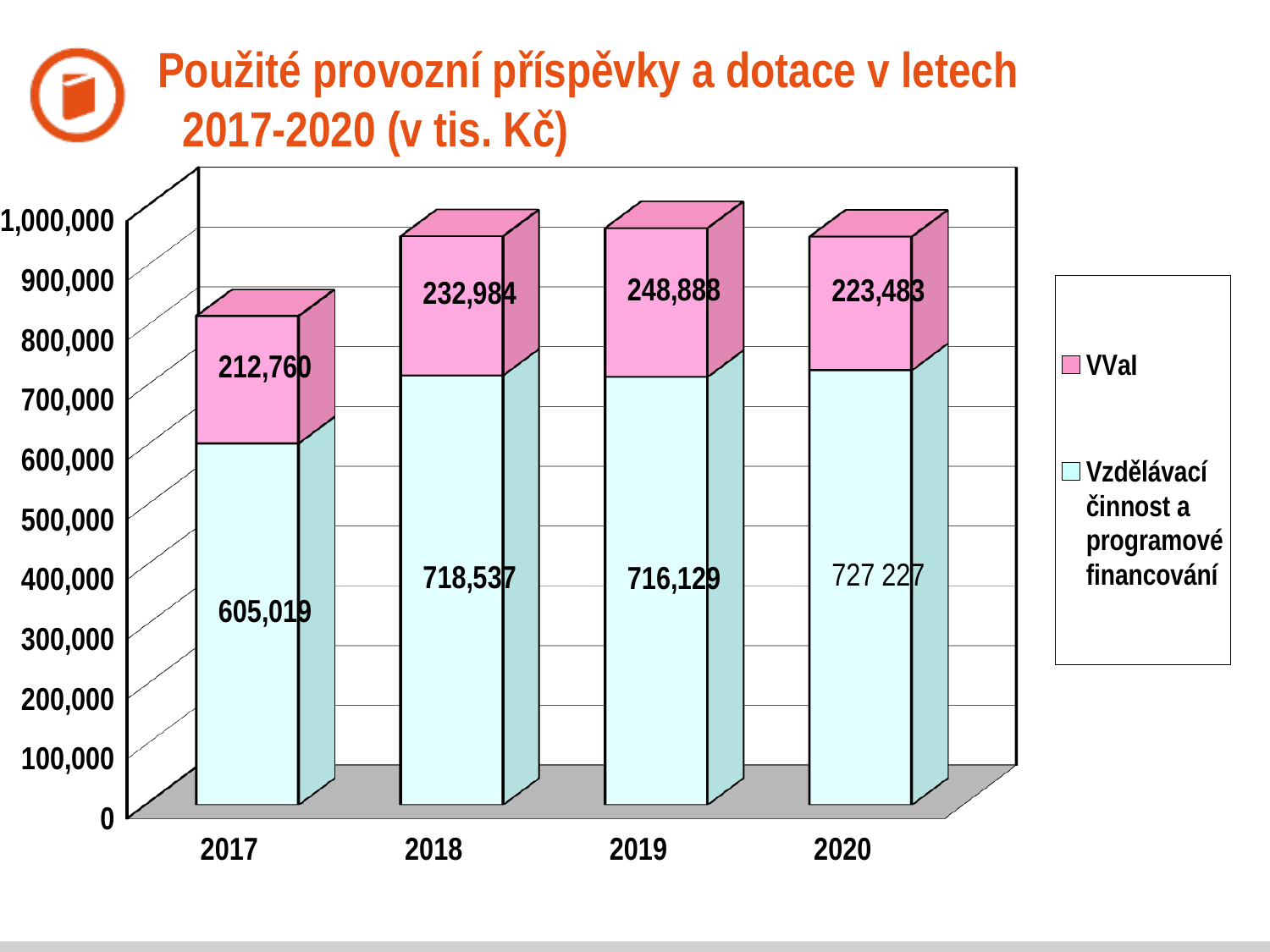
What kind of chart is shown on the slide? Stacked bar chart In which year is the Vzdělávací činnost a programové financování value lowest? 2017 What is the value for Vzdělávací činnost a programové financování in 2017? 605,019 In which year is the VVaI value highest? 2019 How many years are shown on the x axis? 4 What is the difference between the VVaI values for 2018 and 2017? 20,224 Which is larger, the VVaI value for 2020 or for 2018? 2018 What is the value for Vzdělávací činnost a programové financování in 2020? 727 227 What is the value for VVaI in 2019? 248,888 What is the total of the stacked bar for 2017? 817,779 How many series does the legend list? 2 What is the total of the stacked bar for 2019? 965,017